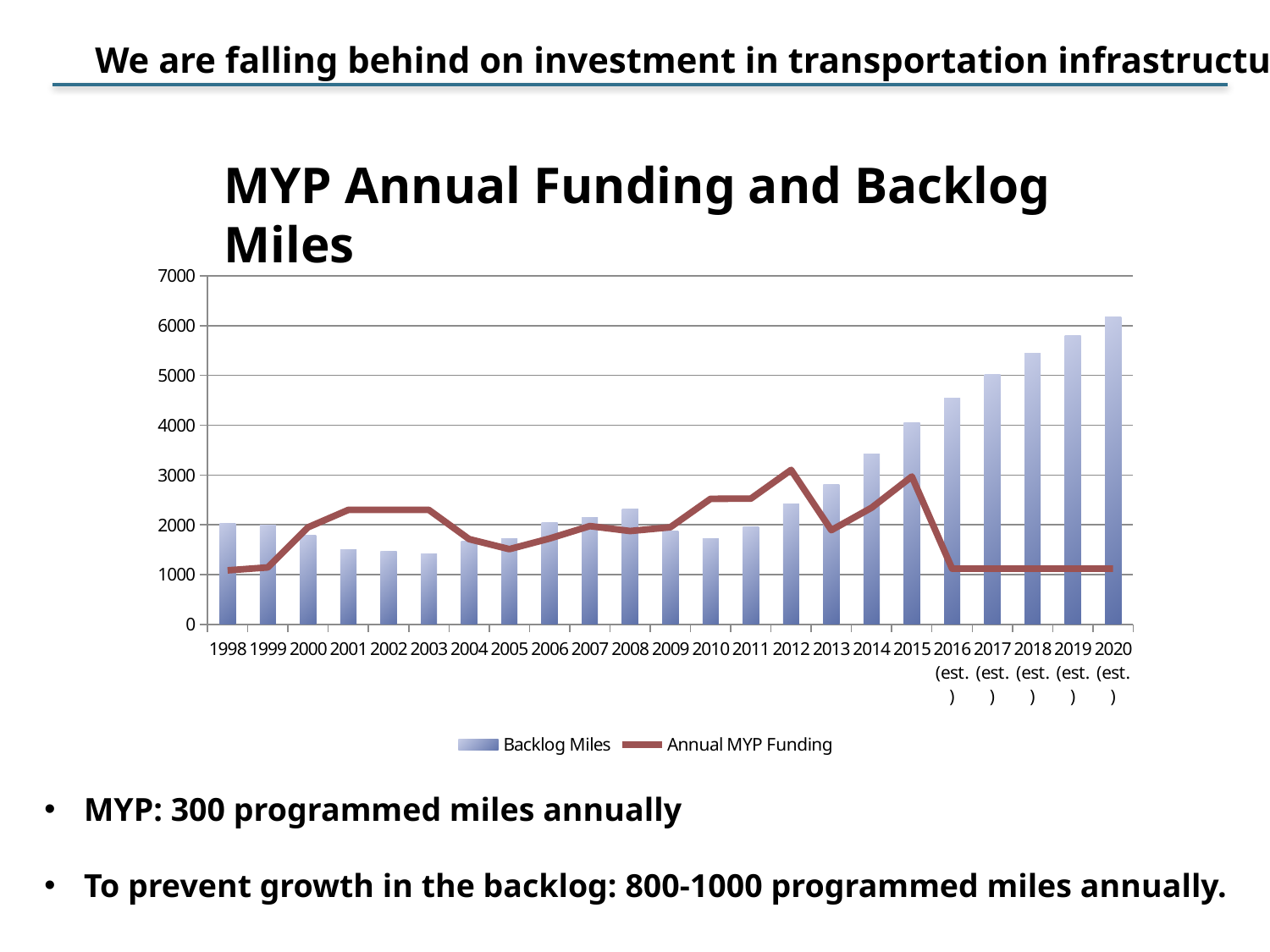
What is the title of the chart? MYP Annual Funding and Backlog Miles Is the Annual MYP Funding value for 2001 greater or less than 2000? greater Which is larger, the Backlog Miles value for 1998 or for 2020 (est.)? 2020 (est.) What are the two series named in the legend? Backlog Miles and Annual MYP Funding Do the Backlog Miles bars rise or fall from 2014 to 2020 (est.)? rise Is the Backlog Miles value for 2016 (est.) greater or less than 4000? greater Which year has the highest Backlog Miles bar? 2020 (est.) How many series does the legend list? 2 How many years are shown along the x axis? 23 Is the Annual MYP Funding value for 2018 (est.) greater or less than 2000? less What kind of chart is shown on the slide? A combined bar and line chart